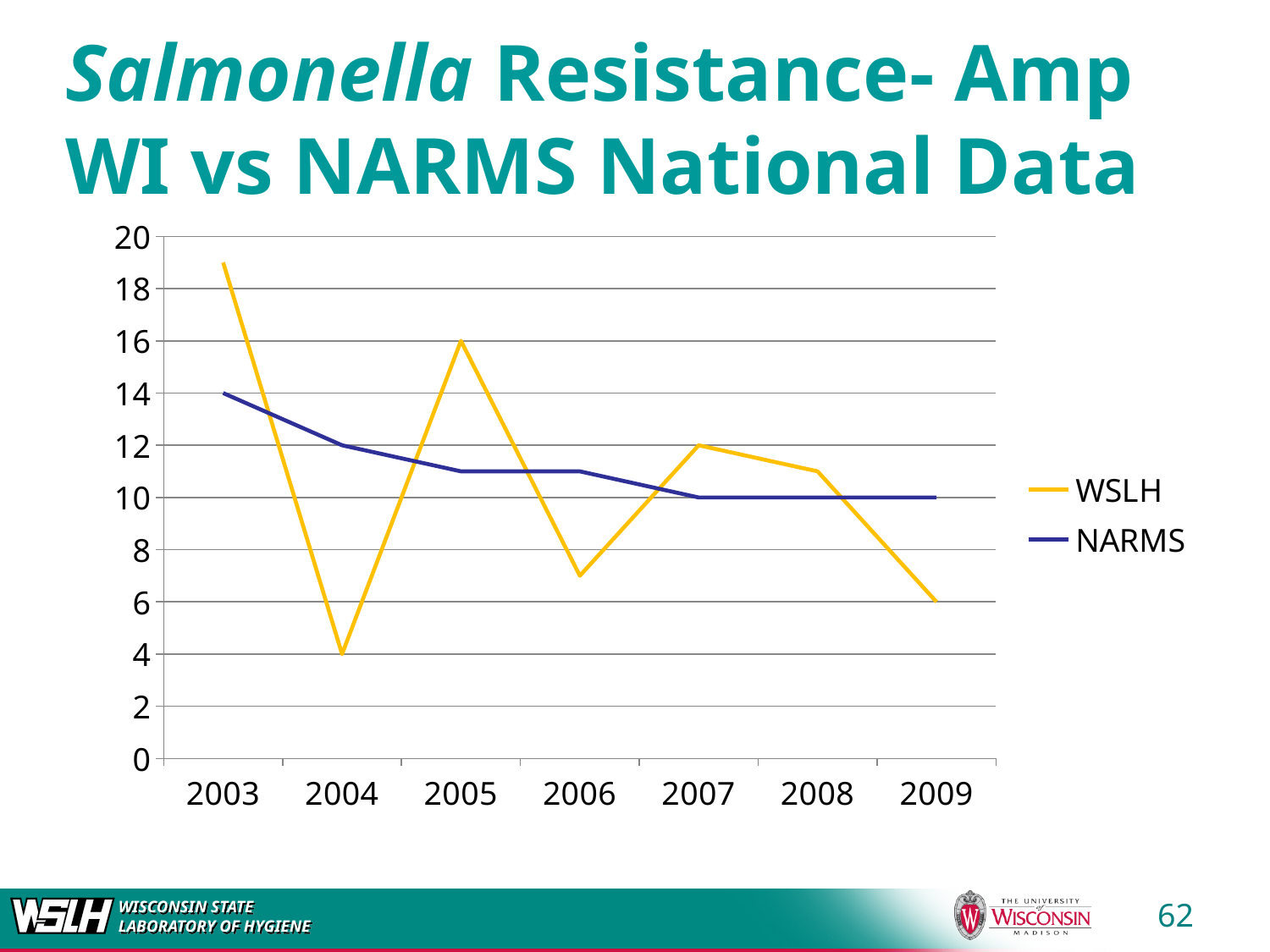
Is the WSLH value for 2006 greater or less than 8? less What is the WSLH value for 2004? 4 What is the difference between the NARMS and WSLH values in 2004? 8 How many series does the legend list? 2 In which year is the WSLH value lowest? 2004 What type of chart is shown on the slide? Line chart In which year is the WSLH value highest? 2003 In 2005, which series has the larger value, WSLH or NARMS? WSLH What is the NARMS value for 2003? 14 How many years are shown on the x axis? 7 Does the NARMS line generally rise or fall from 2003 to 2009? Fall What is the WSLH value for 2005? 16